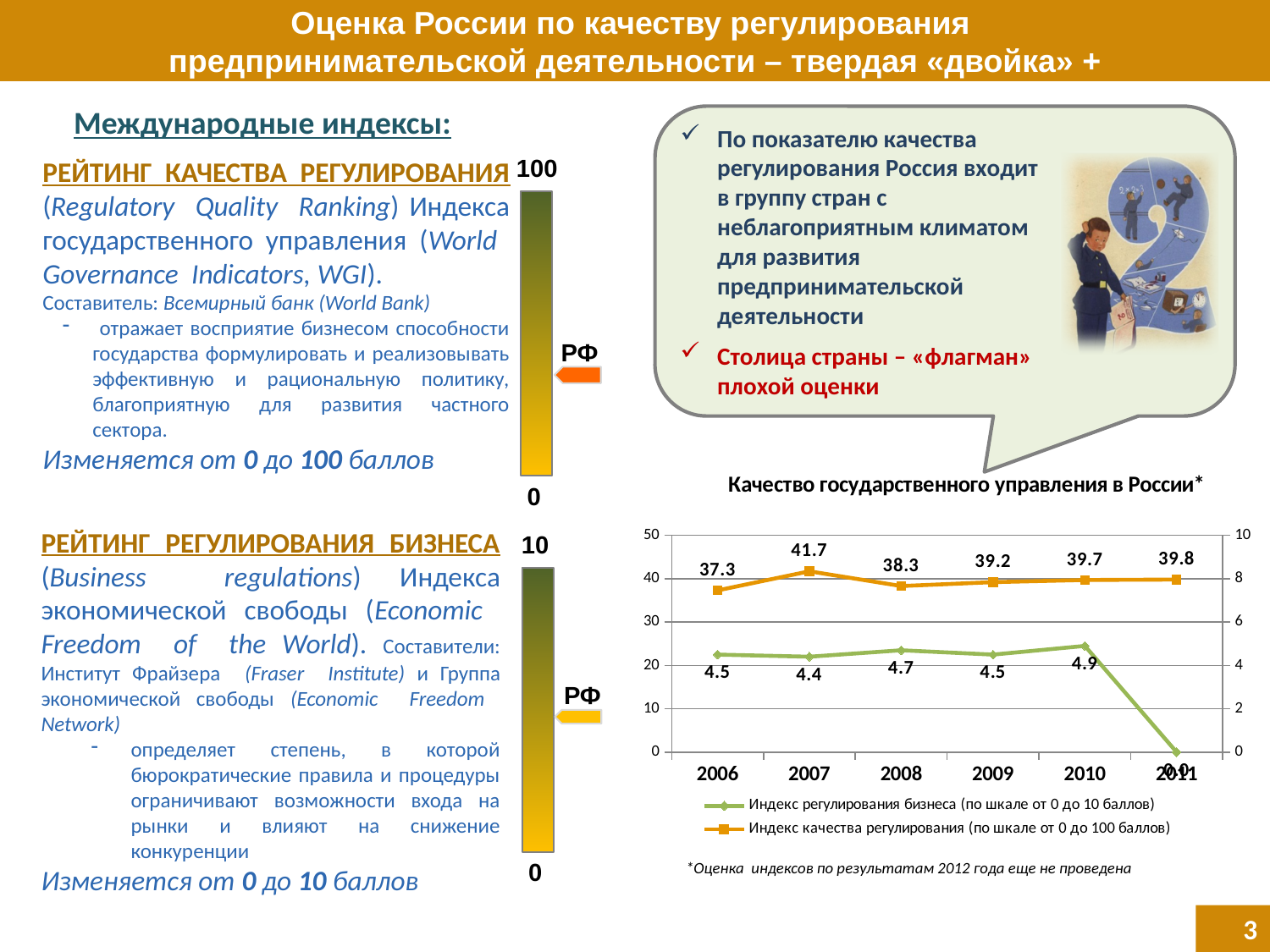
In the chart «Качество государственного управления в России*», in which year is «Индекс качества регулирования» highest? 2007 In the chart «Качество государственного управления в России*», what is the value of «Индекс регулирования бизнеса» for 2010? 4.9 What kind of chart is shown under the title «Качество государственного управления в России*»? line chart In the chart «Качество государственного управления в России*», does «Индекс качества регулирования» rise or fall from 2008 to 2011? rise In the chart «Качество государственного управления в России*», what is the difference between the «Индекс регулирования бизнеса» values for 2010 and 2007? 0.5 In the chart «Качество государственного управления в России*», in which year is «Индекс качества регулирования» lowest? 2006 In the chart «Качество государственного управления в России*», what is the difference between the «Индекс качества регулирования» values for 2007 and 2006? 4.4 In the chart «Качество государственного управления в России*», which year has the larger «Индекс качества регулирования» value, 2008 or 2009? 2009 In the chart «Качество государственного управления в России*», what is the value of «Индекс качества регулирования» for 2007? 41.7 How many years are shown on the x axis of the chart «Качество государственного управления в России*»? 6 In the chart «Качество государственного управления в России*», what is the value of «Индекс регулирования бизнеса» for 2008? 4.7 How many series does the legend of the chart «Качество государственного управления в России*» list? 2